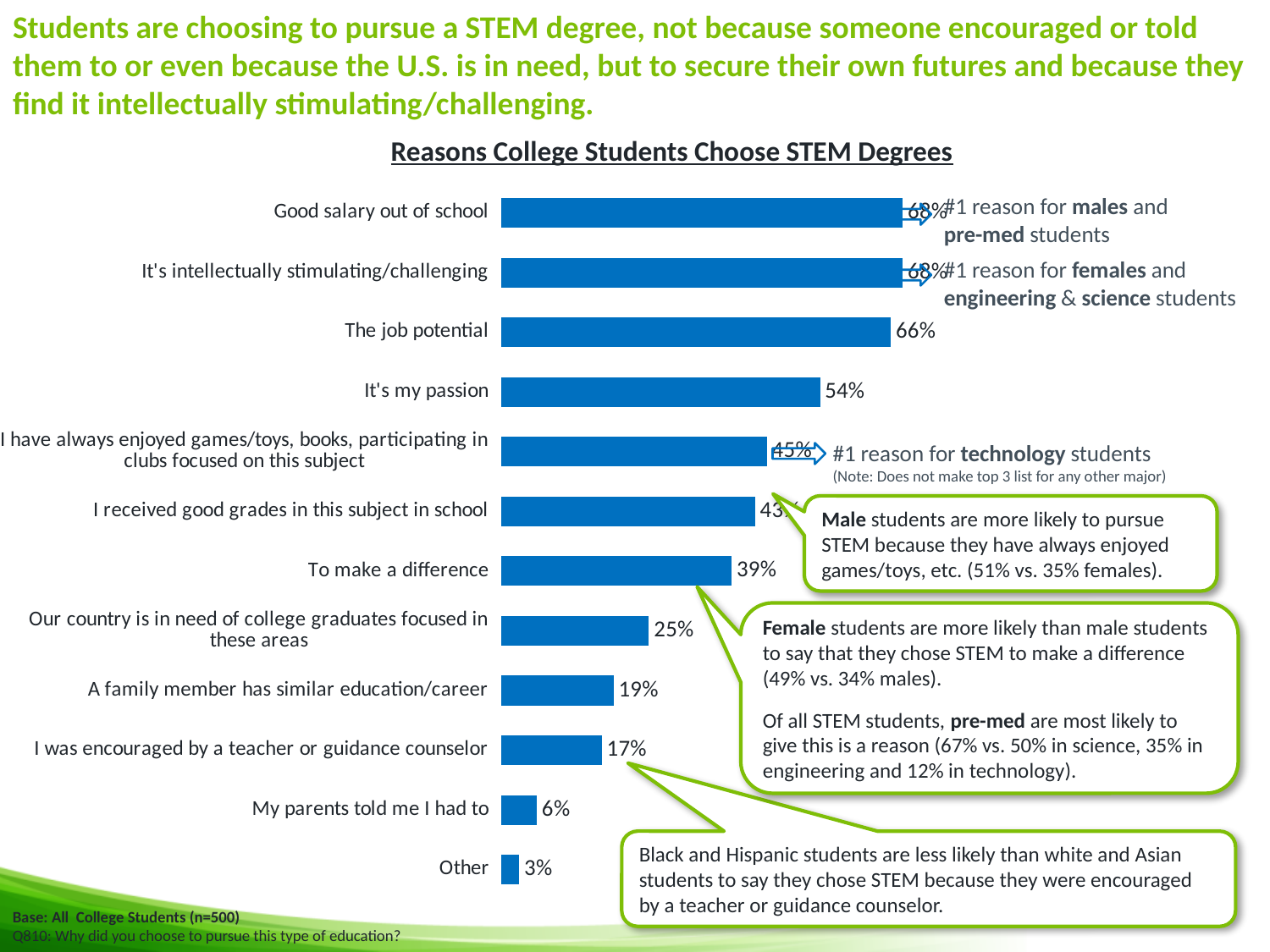
Which is larger: 'Our country is in need of college graduates focused in these areas' or 'A family member has similar education/career'? Our country is in need of college graduates focused in these areas What is the difference between 'The job potential' and 'It's my passion'? 12 percentage points What is the value for 'To make a difference'? 39% What type of chart is shown on the slide? Bar chart Which reason has the lowest value in the chart? Other What percentage of students chose 'The job potential' as a reason? 66% What is the title of the chart? Reasons College Students Choose STEM Degrees What percentage of students said 'I was encouraged by a teacher or guidance counselor'? 17% How many reasons (categories) are plotted in the chart? 12 What is the value for 'My parents told me I had to'? 6% What is the difference between 'A family member has similar education/career' and 'I was encouraged by a teacher or guidance counselor'? 2 percentage points What is the value for 'It's my passion'? 54%